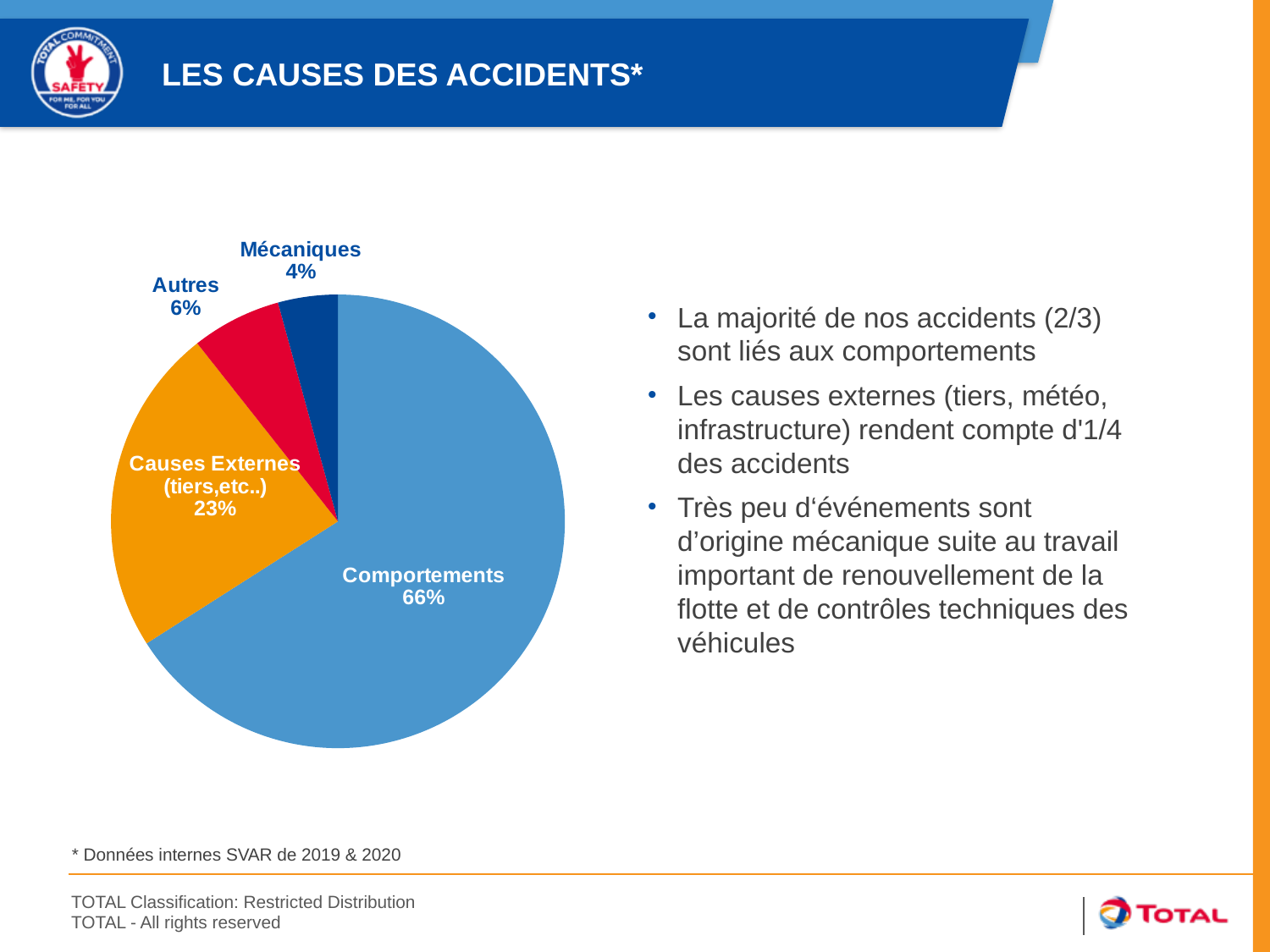
What kind of chart is shown on the slide? pie chart What is the difference in percentage points between Comportements and Causes Externes? 43 Which is larger, the share for Autres or the share for Mécaniques? Autres How many slices does the pie chart have? 4 What share of accidents is attributed to Comportements? 66% What is the title of the slide containing the chart? LES CAUSES DES ACCIDENTS* What share of accidents is attributed to Causes Externes (tiers, etc..)? 23% What share of accidents is attributed to Mécaniques? 4% Which cause has the largest slice of the pie? Comportements Which cause has the smallest slice of the pie? Mécaniques What colour is the Causes Externes slice? orange